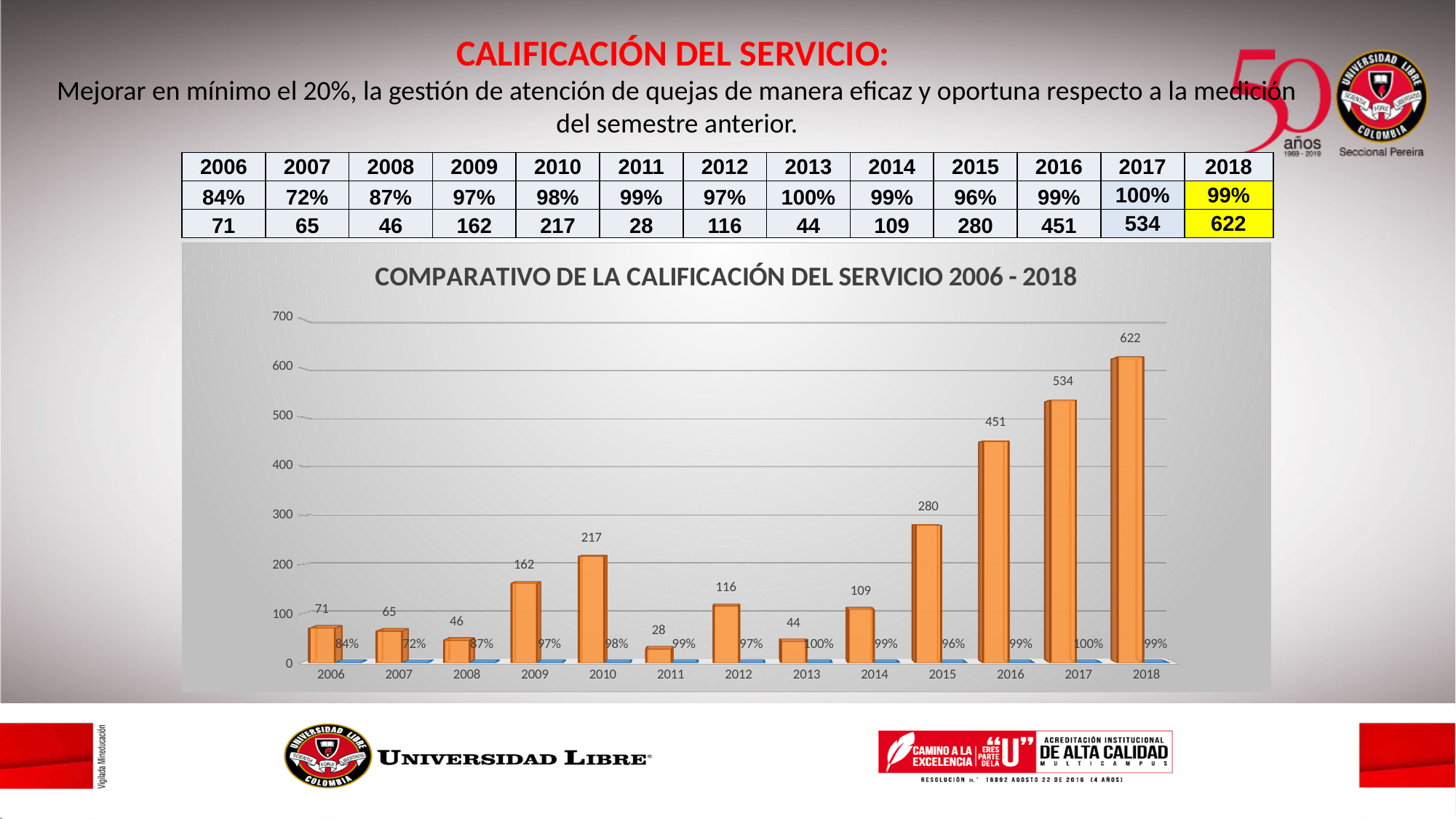
What percentage is shown for 2013 in the chart? 100% How many years are shown on the x axis of the chart? 13 Do the orange bar values generally rise or fall from 2014 to 2018? Rise Which is larger, the orange bar for 2009 or for 2012? 2009 What is the title of the chart? COMPARATIVO DE LA CALIFICACIÓN DEL SERVICIO 2006 - 2018 What is the value of the orange bar for 2011? 28 Which year has the lowest orange bar? 2011 What is the difference between the orange bar values for 2018 and 2017? 88 What is the value of the orange bar for 2018? 622 Is the orange bar for 2016 greater or less than 400? greater What kind of chart is shown on the slide? Bar chart Which year has the highest orange bar? 2018